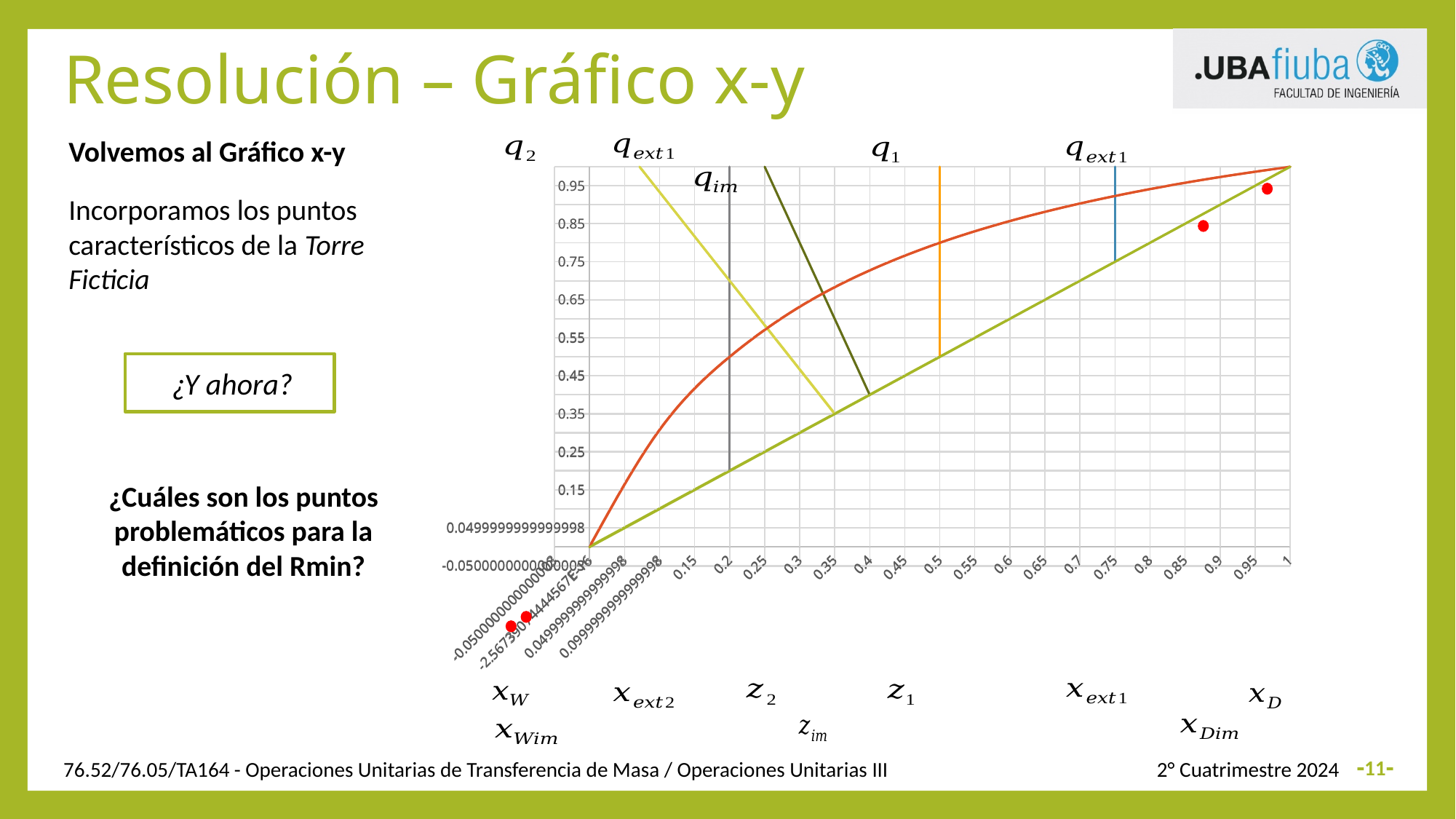
At which x-axis value is the vertical orange line labelled q1 drawn? 0.5 How many red dots are plotted on the chart? 4 Does the red curve rise or fall as x increases from 0 to 1? rise At x = 0.5, which line has the larger y value, the red curve or the green diagonal? the red curve Is the value of the green diagonal line at x = 0.75 greater or less than 0.85? less What is the highest tick value shown on the x axis? 1 At which x-axis value is the vertical grey line labelled q_im drawn? 0.2 At which x-axis value is the vertical blue line labelled q_ext1 drawn? 0.75 Is the value of the red curve at x = 0.2 greater or less than 0.35? greater What kind of chart is shown on the slide? line chart How many vertical lines (q-lines) are drawn on the chart? 3 Is the value of the red curve at x = 0.5 greater or less than 0.65? greater